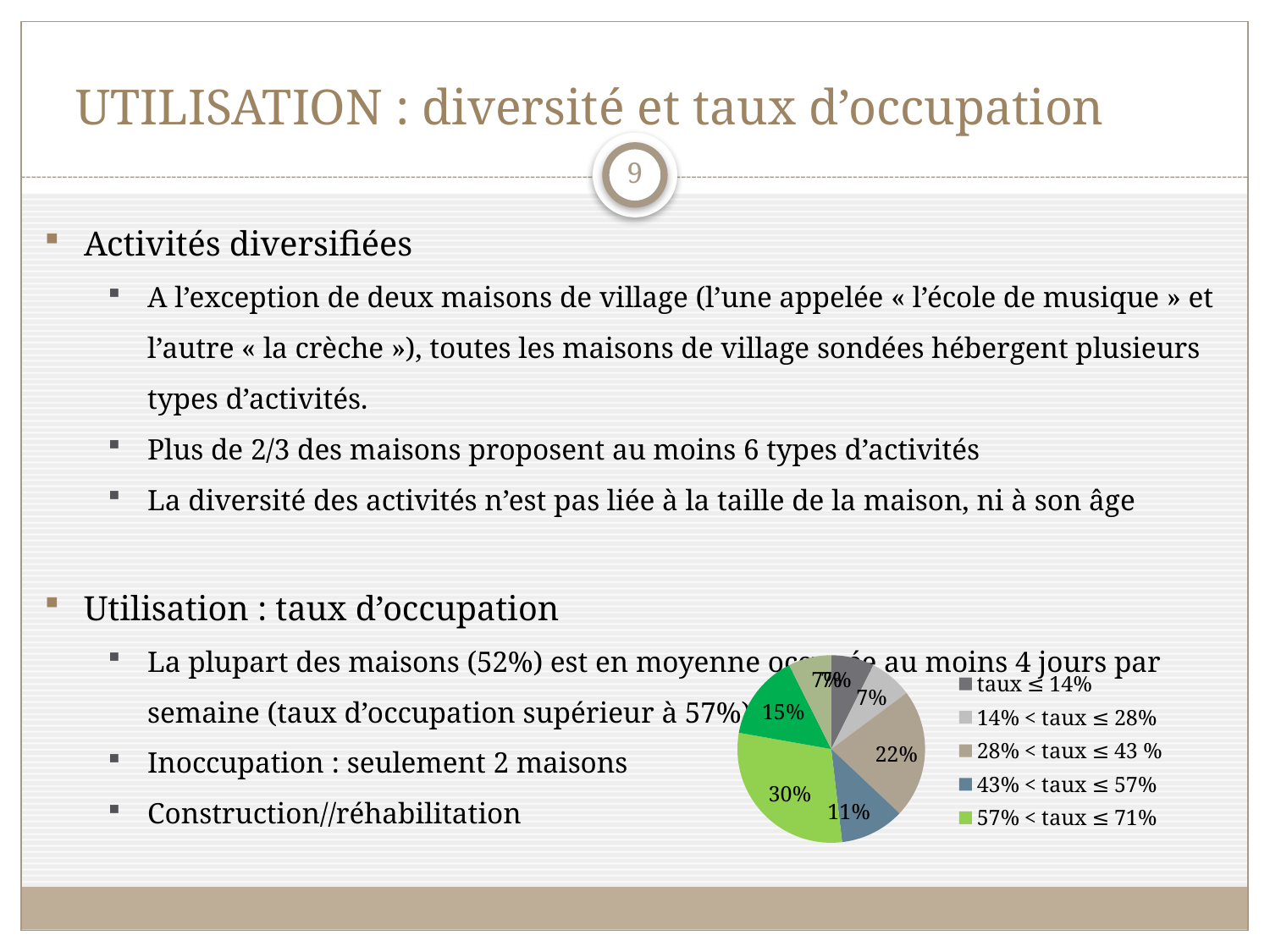
What is the first entry listed in the pie chart's legend? taux ≤ 14% In the pie chart, what share is shown for the category "43% < taux ≤ 57%"? 11% What is the difference between the slices for "57% < taux ≤ 71%" and "28% < taux ≤ 43 %"? 8 percentage points How many entries does the legend of the pie chart list? 5 Which slice is larger: "57% < taux ≤ 71%" or "43% < taux ≤ 57%"? 57% < taux ≤ 71% In the pie chart, what share is shown for the category "57% < taux ≤ 71%"? 30% Which category has the largest slice in the pie chart? 57% < taux ≤ 71% What colour is the slice for "57% < taux ≤ 71%" in the pie chart? light green Which slice is larger: "28% < taux ≤ 43 %" or "43% < taux ≤ 57%"? 28% < taux ≤ 43 % What is the difference between the slices for "28% < taux ≤ 43 %" and "43% < taux ≤ 57%"? 11 percentage points What kind of chart is shown on the slide? pie chart In the pie chart, what share is shown for the category "28% < taux ≤ 43 %"? 22%